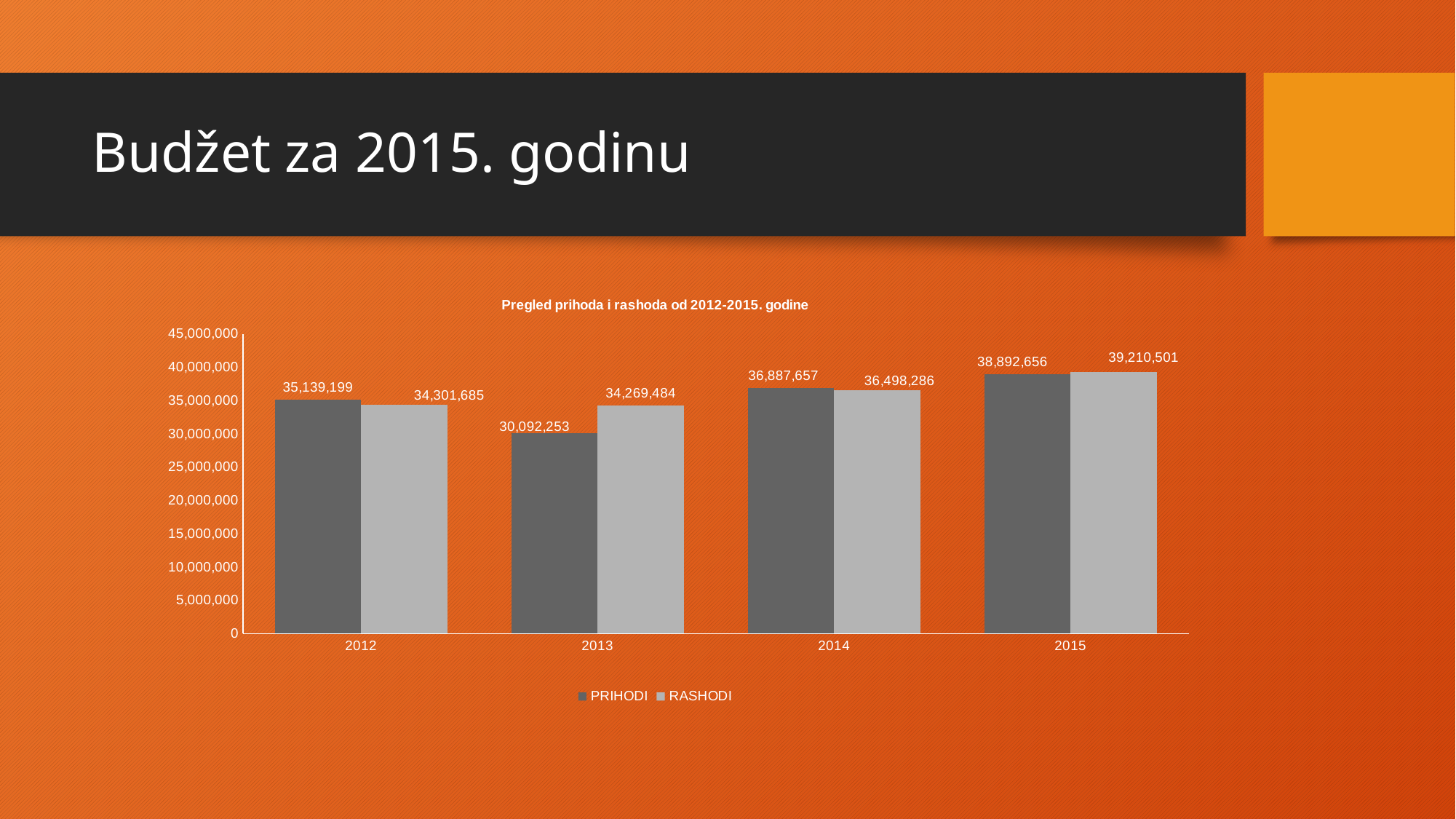
What is the PRIHODI value for 2014? 36,887,657 What is the title of the chart? Pregled prihoda i rashoda od 2012-2015. godine Do the PRIHODI values rise or fall from 2013 to 2015? rise What is the PRIHODI value for 2013? 30,092,253 How many series does the legend list? 2 How many years are shown on the x axis? 4 In which year is PRIHODI the highest? 2015 What type of chart is shown on the slide? bar chart What is the difference between RASHODI and PRIHODI in 2013? 4,177,231 What is the RASHODI value for 2015? 39,210,501 In which year is PRIHODI the lowest? 2013 In 2012, which is larger, PRIHODI or RASHODI? PRIHODI